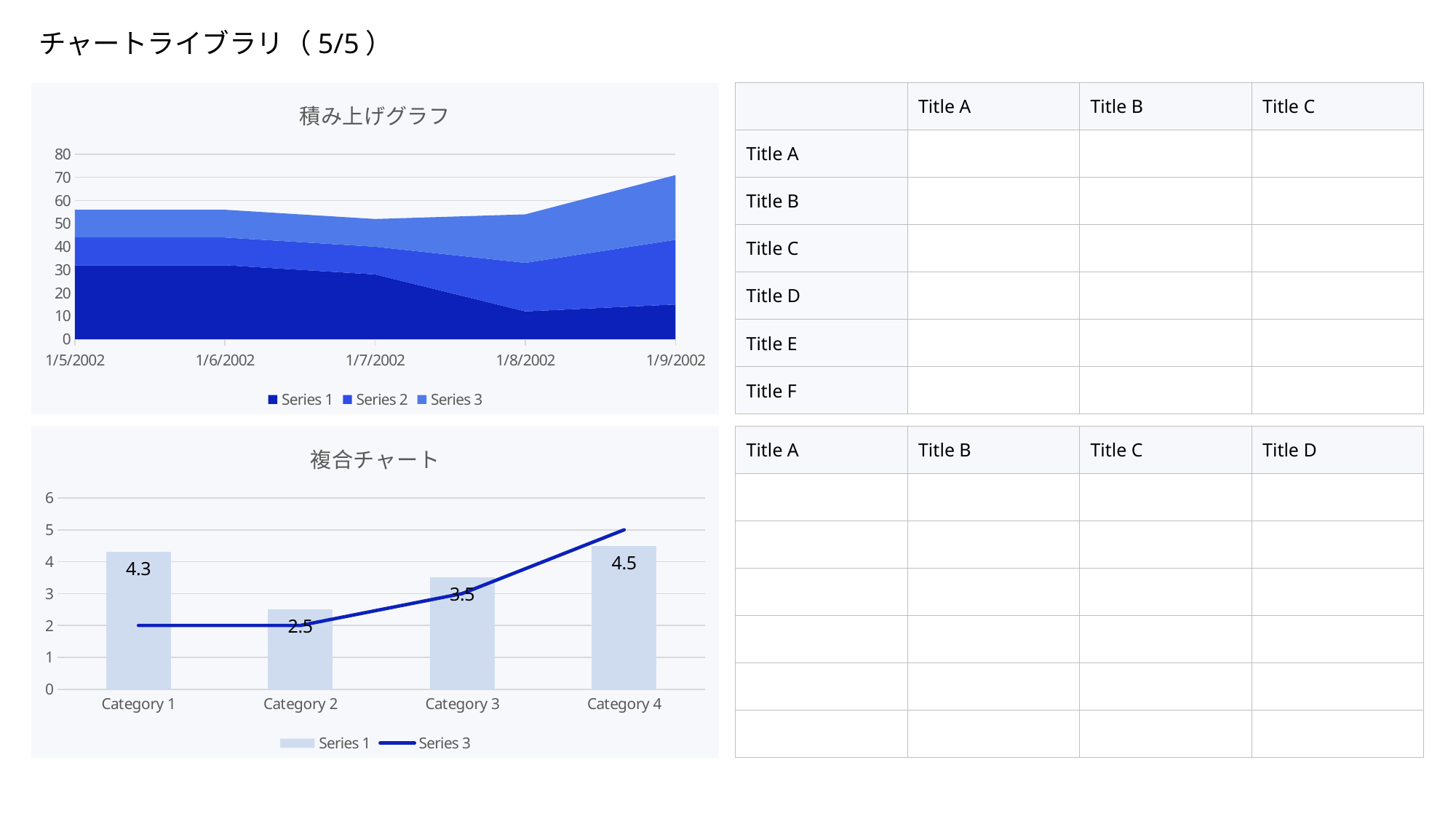
In the 複合チャート chart, which category has the highest Series 1 bar? Category 4 In the 積み上げグラフ chart, does Series 1 rise or fall from 1/5/2002 to 1/8/2002? fall In the 積み上げグラフ chart, is the value for Series 1 at 1/8/2002 greater or less than 20? less In the 複合チャート chart, is the Series 1 value larger for Category 1 or Category 3? Category 1 In the 複合チャート chart, what is the value of Series 1 for Category 1? 4.3 In the 積み上げグラフ chart, is the stacked total at 1/9/2002 greater or less than 60? greater In the 複合チャート chart, what is the difference between the Series 1 values for Category 4 and Category 2? 2 How many dates are shown on the x axis of the 積み上げグラフ chart? 5 In the 複合チャート chart, which category has the lowest Series 1 bar? Category 2 What type of chart is the 積み上げグラフ chart? stacked area chart In the 複合チャート chart, is the Series 3 line value at Category 4 greater or less than 4? greater How many series does the legend of the 積み上げグラフ chart list? 3